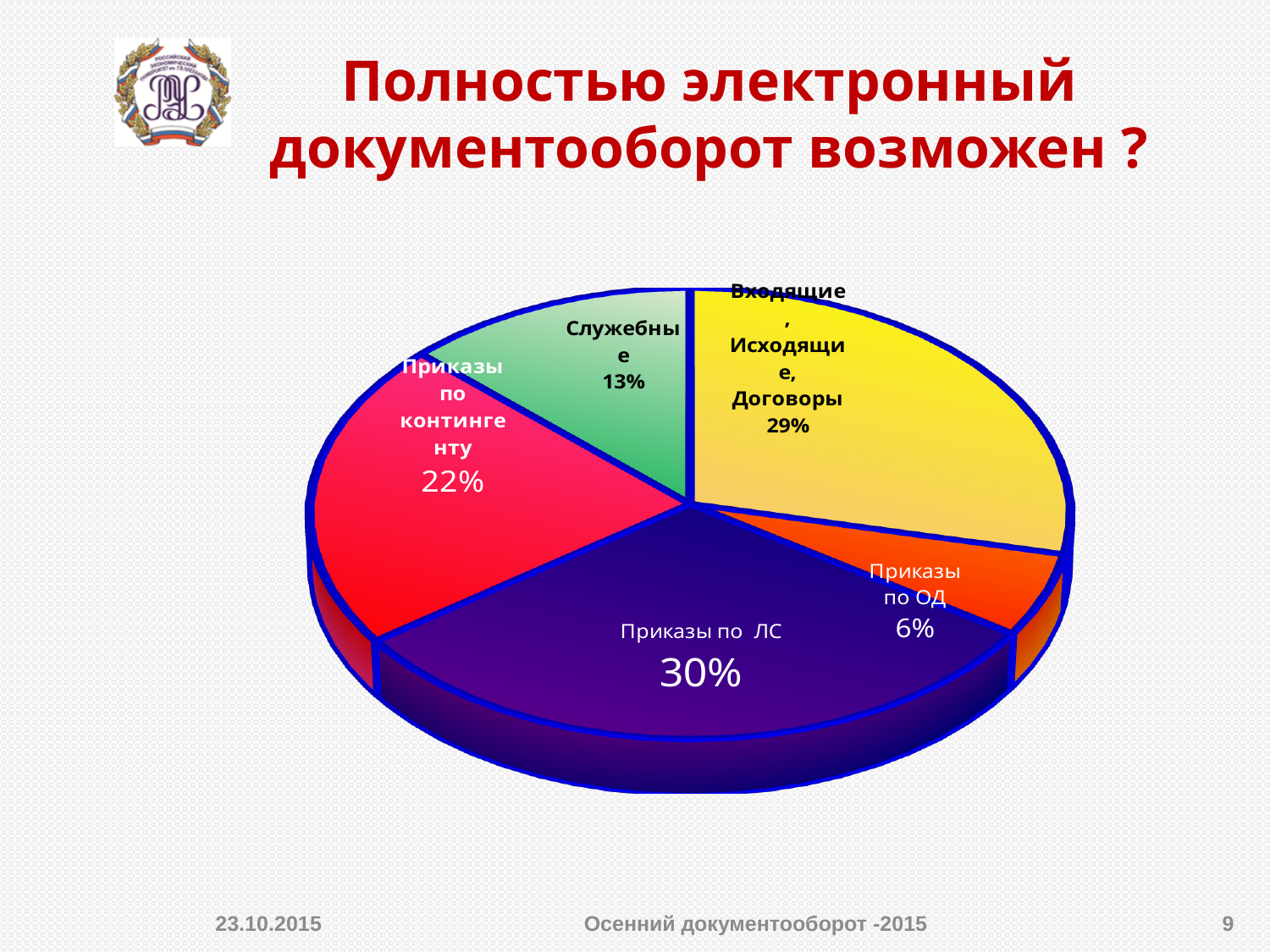
What share of the pie does "Приказы по ОД" have? 6% Which is larger: the share for "Служебные" or the share for "Приказы по контингенту"? Приказы по контингенту What colour is the "Приказы по ЛС" slice? purple What is the difference in percentage points between "Приказы по ЛС" and "Приказы по контингенту"? 8 What share of the pie does "Входящие, Исходящие, Договоры" have? 29% What share of the pie does "Служебные" have? 13% How many slices does the pie chart have? 5 What kind of chart is shown on the slide? pie chart Which slice of the pie chart is the smallest? Приказы по ОД Which slice of the pie chart is the largest? Приказы по ЛС